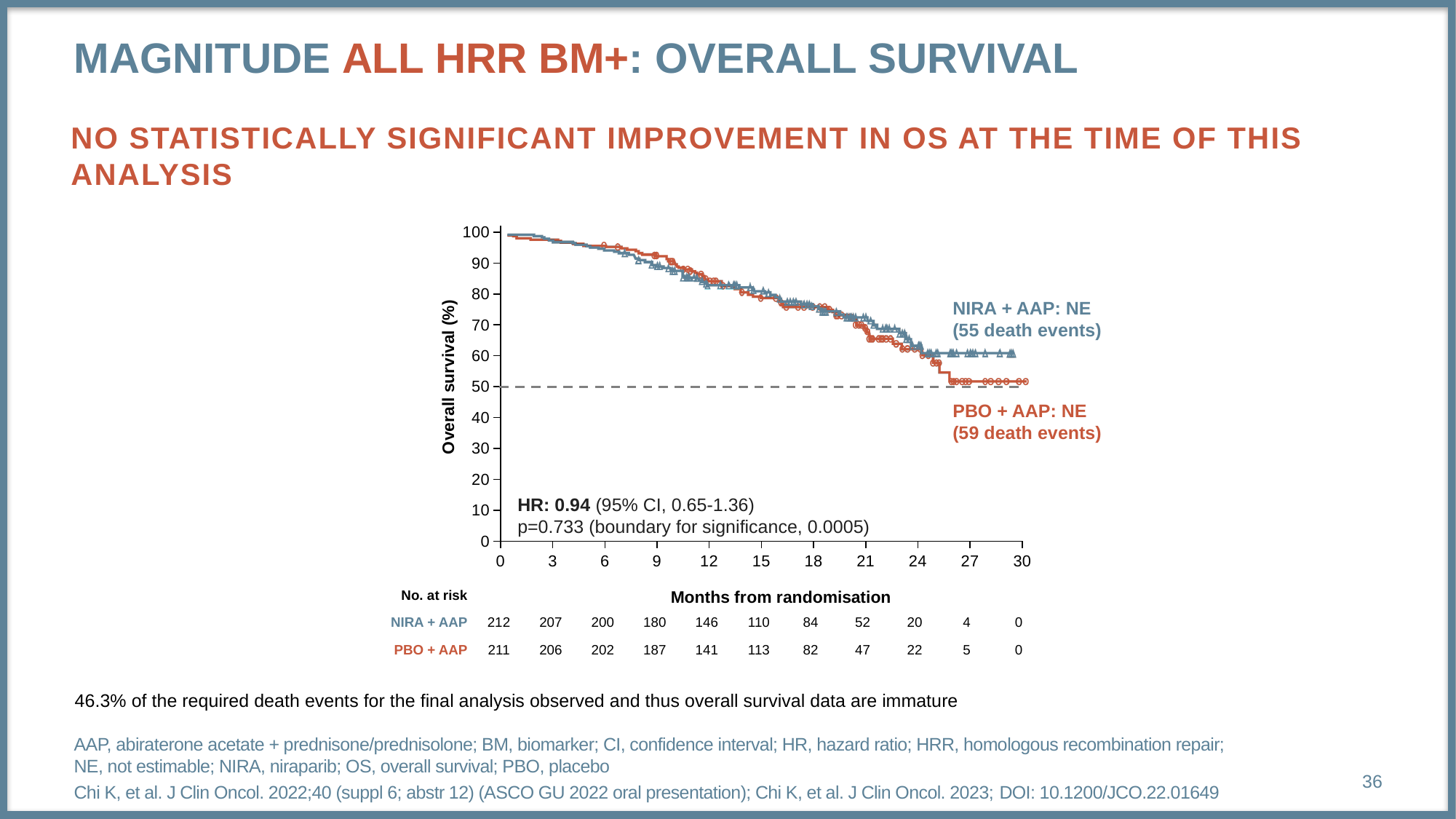
How many death events are reported for the NIRA + AAP arm? 55 How many treatment arms (series) are plotted on the chart? 2 How many death events are reported for the PBO + AAP arm? 59 Do the survival curves rise or fall as months from randomisation increase? fall How many patients were at risk in the PBO + AAP arm at month 12? 141 Which arm had more death events, NIRA + AAP or PBO + AAP? PBO + AAP What kind of chart is shown on the slide? line chart (Kaplan-Meier survival curve) At month 30, is the overall survival value for the NIRA + AAP curve greater or less than 50? greater What is the difference in the number of death events between the PBO + AAP and NIRA + AAP arms? 4 What is the p-value shown on the chart? 0.733 What is the hazard ratio shown on the chart? 0.94 How many patients were at risk in the NIRA + AAP arm at month 0? 212